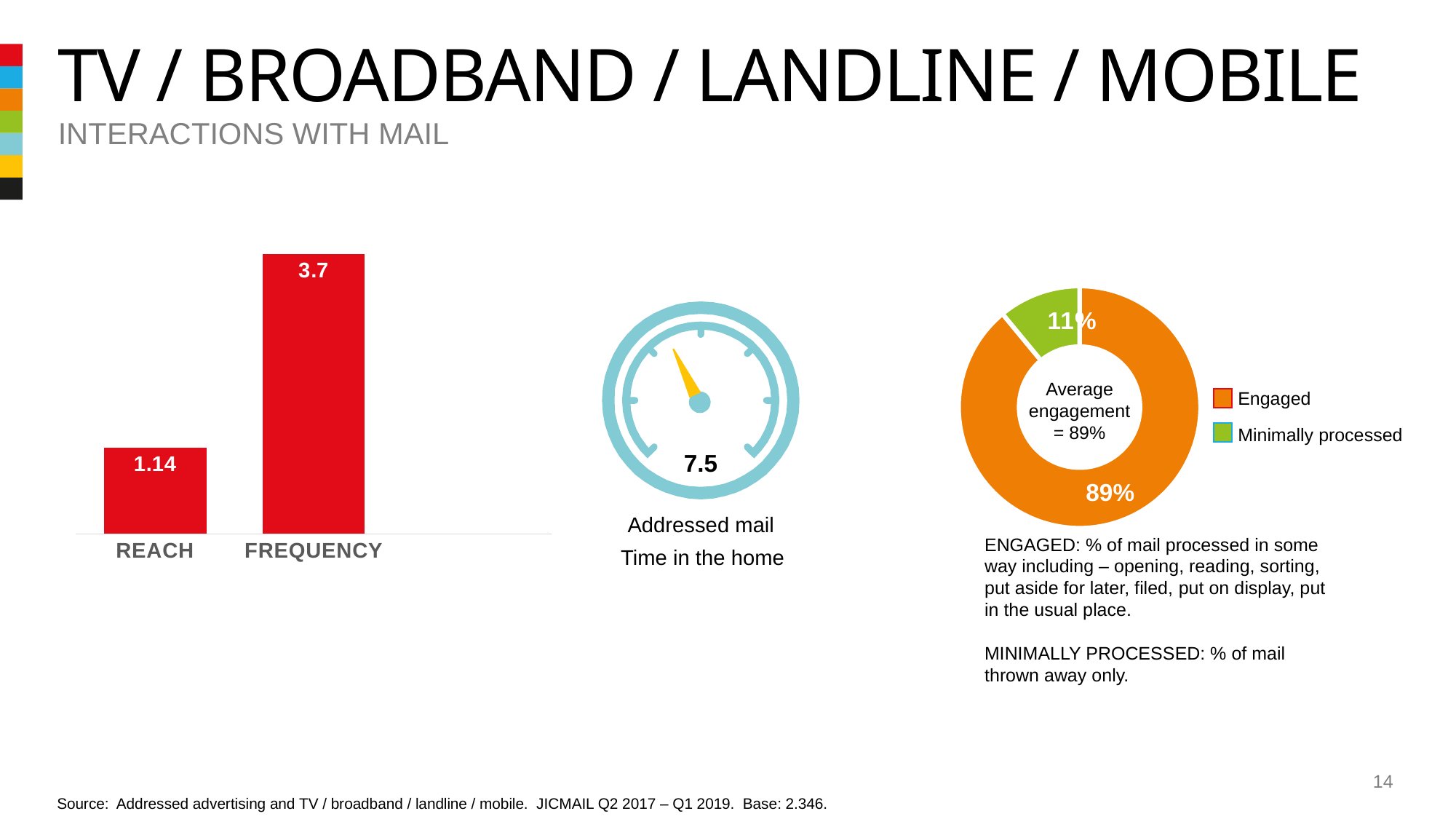
In the bar chart on the left, which category has the lower value? REACH How many entries does the legend of the donut chart on the right list? 2 In the donut chart on the right, what share is Engaged? 89% In the bar chart on the left, how many categories are shown? 2 In the bar chart on the left, what is the difference between the FREQUENCY and REACH values? 2.56 In the bar chart on the left, what is the value for REACH? 1.14 In the donut chart on the right, what share is Minimally processed? 11% In the bar chart on the left, which category has the higher value? FREQUENCY In the bar chart on the left, what is the value for FREQUENCY? 3.7 What kind of chart is the chart on the left of the slide? Bar chart What value is shown on the gauge in the middle of the slide for addressed mail time in the home? 7.5 In the donut chart on the right, which slice is larger, Engaged or Minimally processed? Engaged